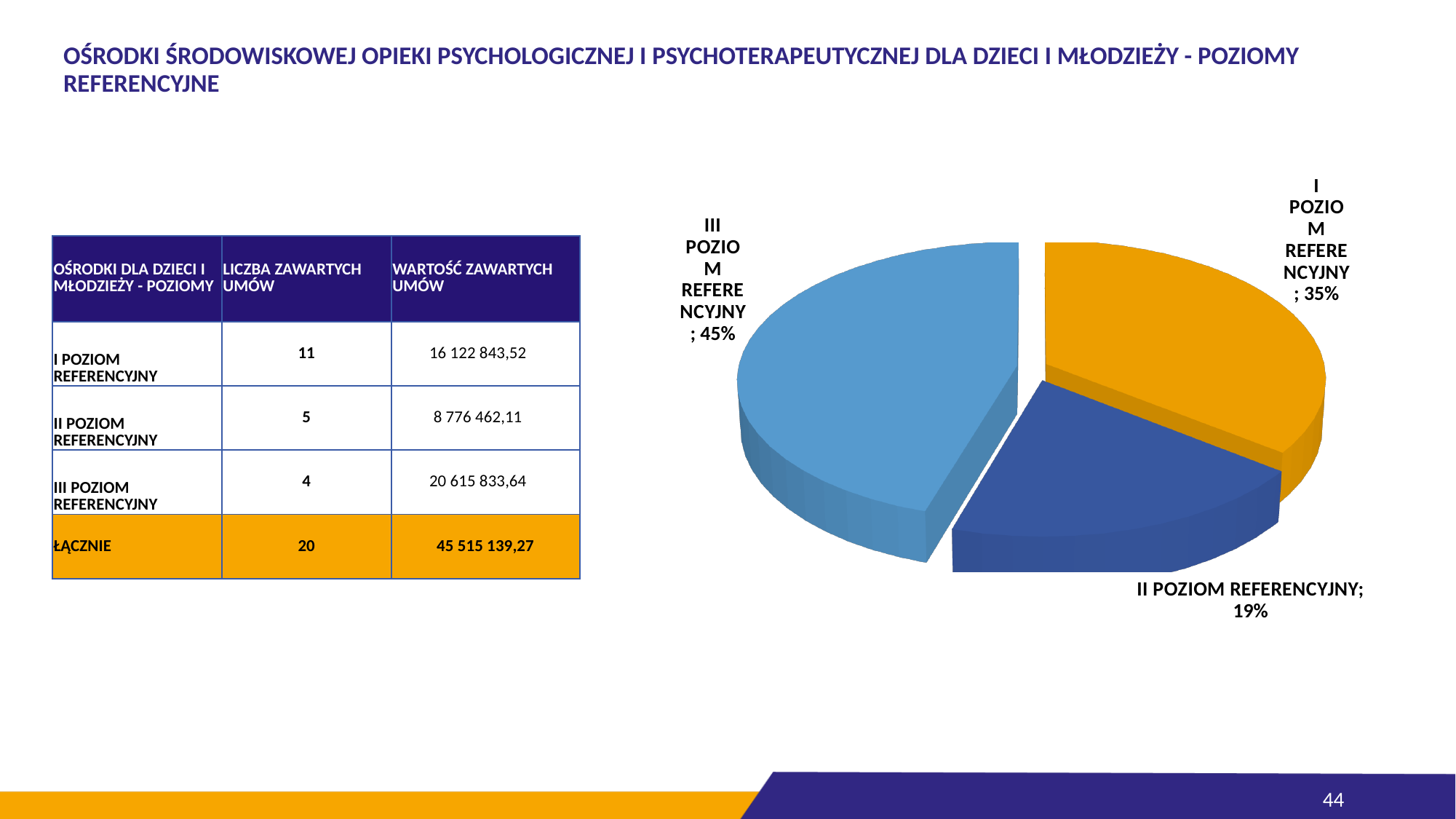
How many slices does the pie chart have? 3 What is the difference in percentage points between the III POZIOM REFERENCYJNY and II POZIOM REFERENCYJNY slices? 26 Which slice of the pie chart is the smallest? II POZIOM REFERENCYJNY In the pie chart, which is larger: I POZIOM REFERENCYJNY or II POZIOM REFERENCYJNY? I POZIOM REFERENCYJNY What is the difference in percentage points between the III POZIOM REFERENCYJNY and I POZIOM REFERENCYJNY slices? 10 What kind of chart is shown on the slide? pie chart What colour is the I POZIOM REFERENCYJNY slice in the pie chart? orange What share of the pie chart does II POZIOM REFERENCYJNY have? 19% What share of the pie chart does III POZIOM REFERENCYJNY have? 45% What share of the pie chart does I POZIOM REFERENCYJNY have? 35% Which slice of the pie chart is the largest? III POZIOM REFERENCYJNY What colour is the II POZIOM REFERENCYJNY slice in the pie chart? dark blue